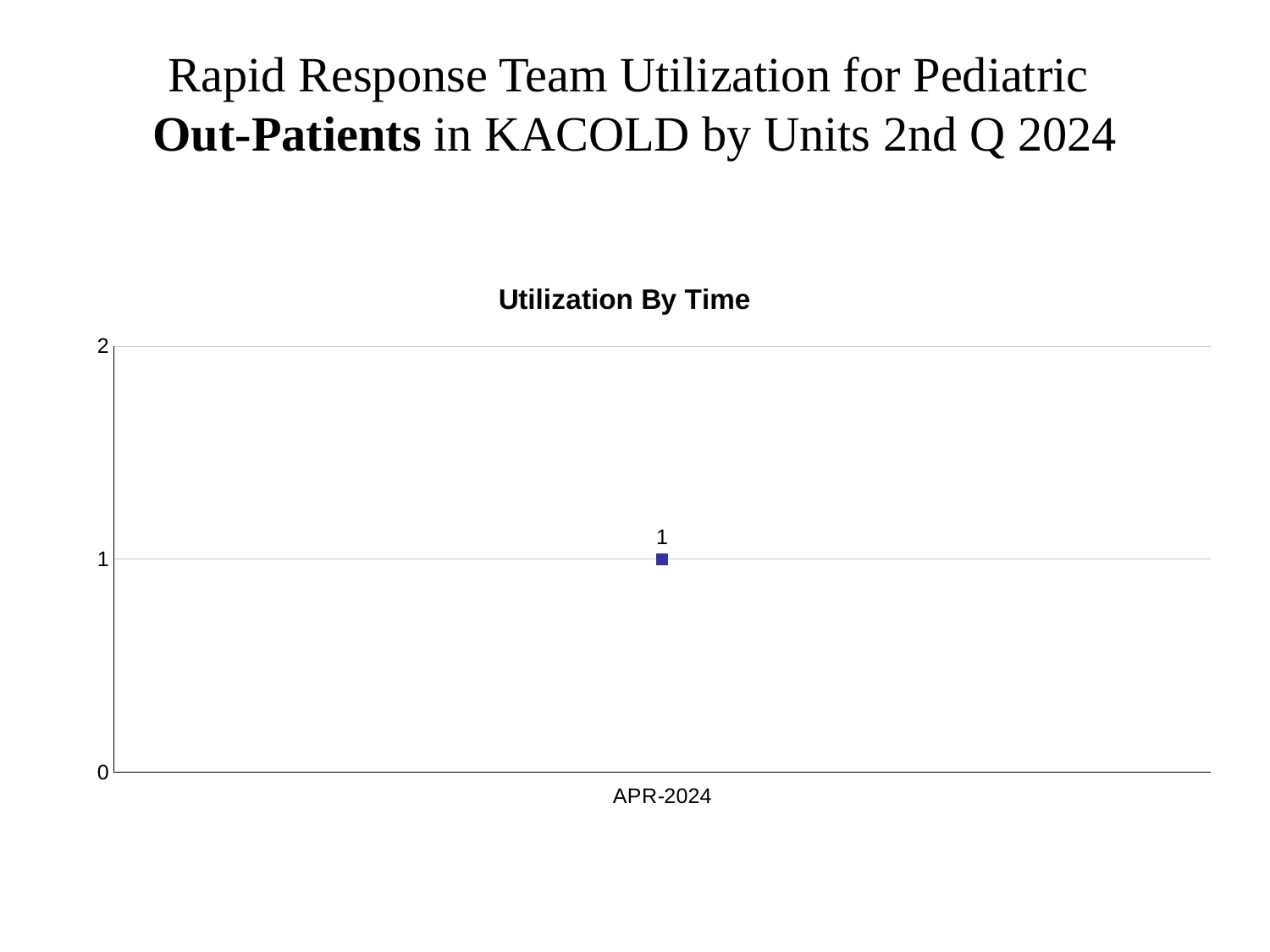
Is the value for APR-2024 greater or less than 2? less What is the title of the chart? Utilization By Time What is the value for APR-2024? 1 Which category is shown on the x axis? APR-2024 What is the highest value shown on the vertical axis? 2 How many data points are plotted on the chart? 1 What kind of chart is shown? line chart